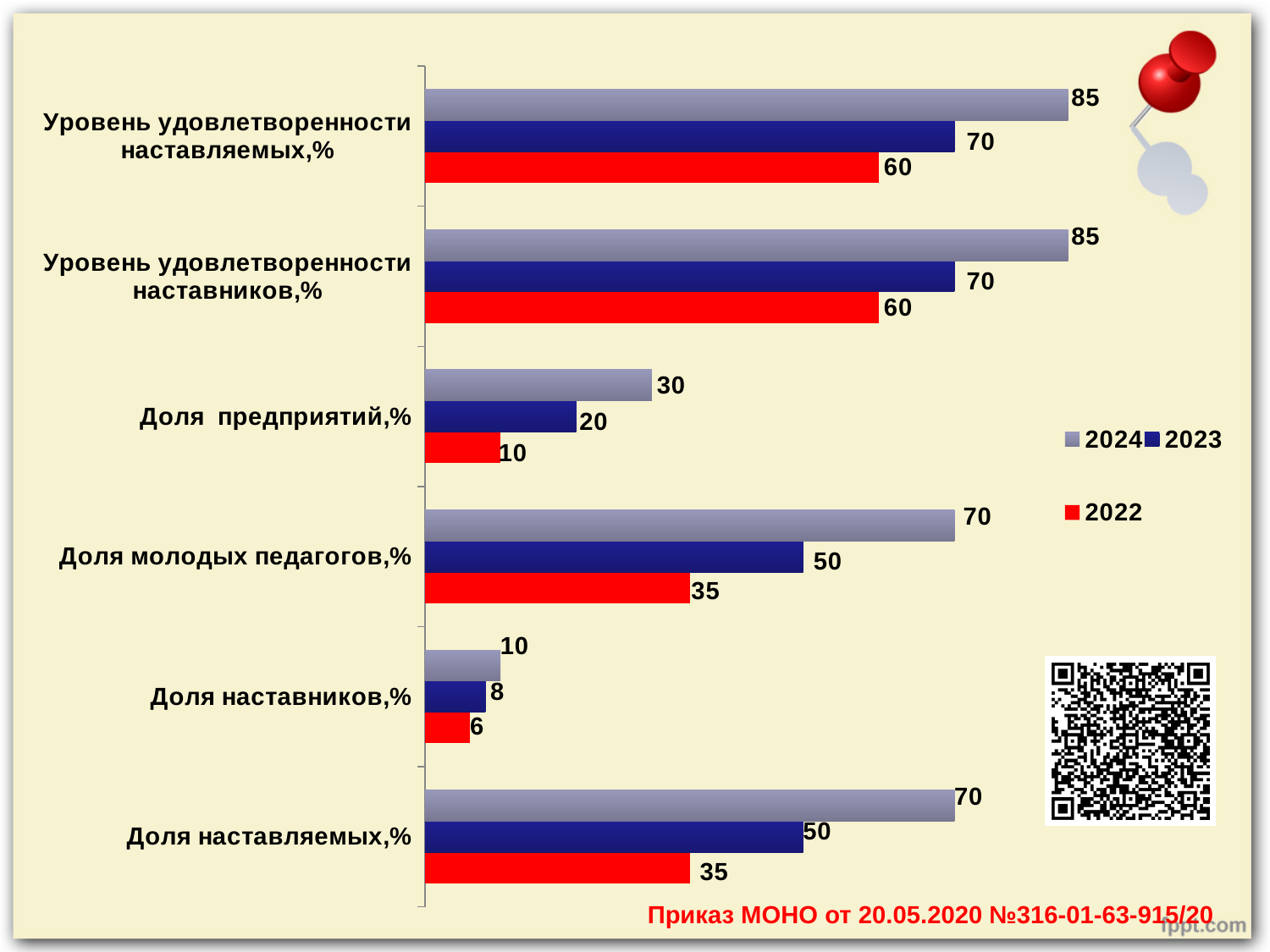
What is the value for 2024 in the category "Доля молодых педагогов,%"? 70 Which category has the lowest value for 2024? Доля наставников,% What is the value for 2022 in the category "Доля предприятий,%"? 10 How many series does the legend list? 3 What kind of chart is shown on the slide? Bar chart Which colour represents the 2022 series in the legend? Red How many categories are shown on the chart? 6 What is the difference between the 2024 and 2022 values for "Доля наставляемых,%"? 35 What is the difference between the 2024 and 2023 values for "Уровень удовлетворенности наставляемых,%"? 15 Which is larger for "Доля предприятий,%": the 2023 value or the 2022 value? 2023 What is the value for 2022 in the category "Уровень удовлетворенности наставников,%"? 60 What is the value for 2023 in the category "Доля наставников,%"? 8